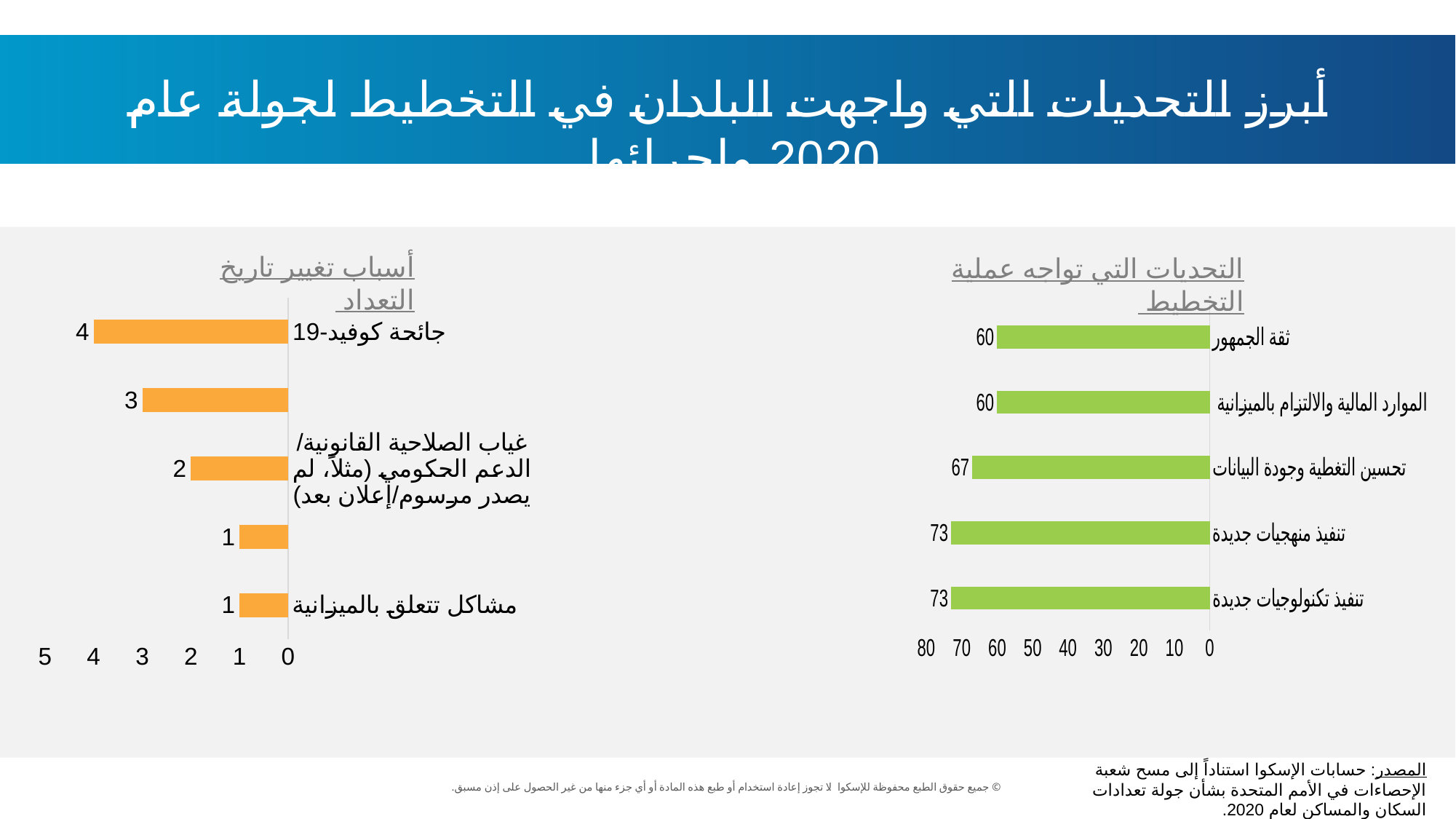
What colour are the bars in the chart titled "أسباب تغيير تاريخ التعداد"? orange In the chart titled "أسباب تغيير تاريخ التعداد", what is the value for "مشاكل تتعلق بالميزانية"? 1 In the chart titled "أسباب تغيير تاريخ التعداد", what is the value for "جائحة كوفيد-19"? 4 What kind of chart is the chart titled "التحديات التي تواجه عملية التخطيط"? bar chart In the chart titled "التحديات التي تواجه عملية التخطيط", what is the difference between the values for "تنفيذ منهجيات جديدة" and "ثقة الجمهور"? 13 In the chart titled "أسباب تغيير تاريخ التعداد", what is the difference between the values for "جائحة كوفيد-19" and "مشاكل تتعلق بالميزانية"? 3 In the chart titled "التحديات التي تواجه عملية التخطيط", what is the value for "تنفيذ تكنولوجيات جديدة"? 73 In the chart titled "التحديات التي تواجه عملية التخطيط", which is larger: the value for "تحسين التغطية وجودة البيانات" or the value for "الموارد المالية والالتزام بالميزانية"? تحسين التغطية وجودة البيانات In the chart titled "التحديات التي تواجه عملية التخطيط", what is the value for "ثقة الجمهور"? 60 In the chart titled "أسباب تغيير تاريخ التعداد", which category has the highest value? جائحة كوفيد-19 In the chart titled "التحديات التي تواجه عملية التخطيط", what is the value for "تحسين التغطية وجودة البيانات"? 67 In the chart titled "التحديات التي تواجه عملية التخطيط", how many categories are plotted? 5